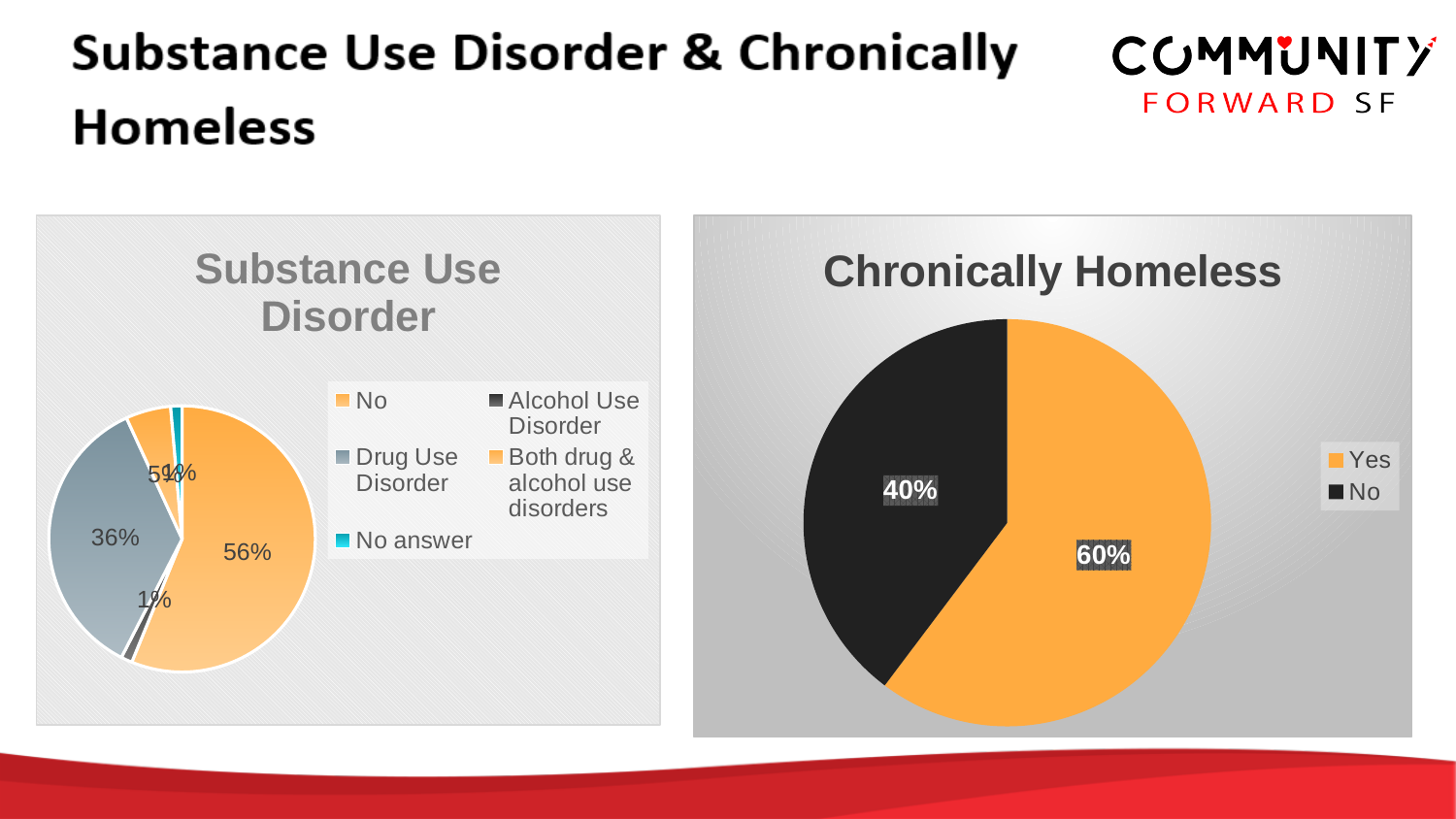
In the "Chronically Homeless" chart, what share is labelled "No"? 40% What kind of chart is the "Chronically Homeless" chart? pie chart In the "Substance Use Disorder" chart, what share is labelled "Drug Use Disorder"? 36% How many entries does the legend of the "Chronically Homeless" chart list? 2 In the "Chronically Homeless" chart, which slice is larger, Yes or No? Yes What kind of chart is the "Substance Use Disorder" chart? pie chart In the "Chronically Homeless" chart, what share is labelled "Yes"? 60% In the "Substance Use Disorder" chart, which category has the largest slice? No How many categories does the legend of the "Substance Use Disorder" chart list? 5 In the "Substance Use Disorder" chart, what share is labelled "No"? 56% In the "Chronically Homeless" chart, what is the difference between the Yes and No shares? 20% In the "Substance Use Disorder" chart, what is the difference between the "No" and "Drug Use Disorder" shares? 20%